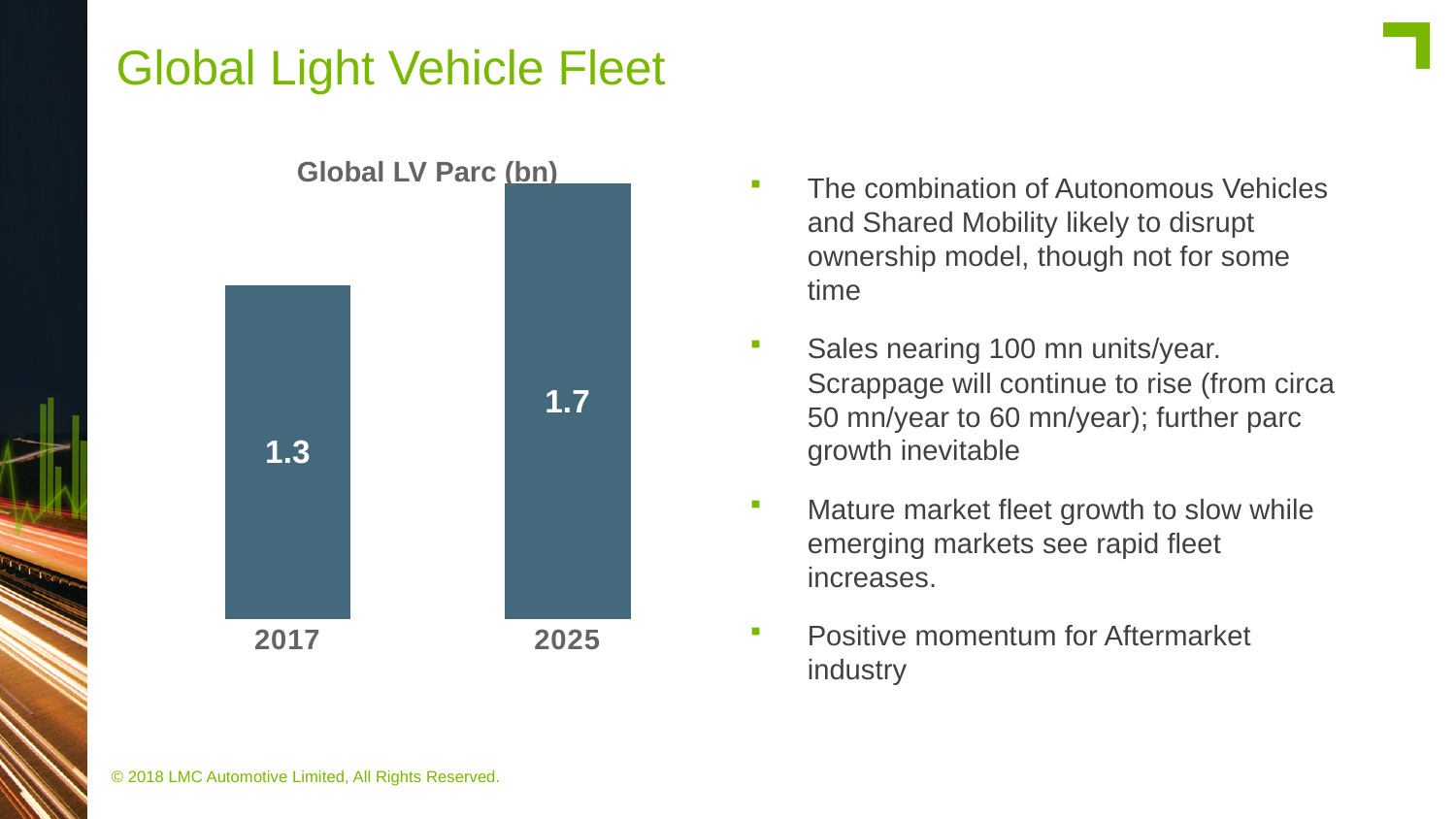
What kind of chart is used to show the Global LV Parc (bn) data? bar chart What unit is indicated in the chart title? bn How many bars are shown in the Global LV Parc (bn) chart? 2 Which year has the lower value in the Global LV Parc (bn) chart? 2017 Is the value for 2025 larger or smaller than the value for 2017 in the Global LV Parc (bn) chart? larger What is the value for 2017 in the Global LV Parc (bn) chart? 1.3 What is the value for 2025 in the Global LV Parc (bn) chart? 1.7 What is the difference between the 2025 and 2017 values in the Global LV Parc (bn) chart? 0.4 What is the title of the chart on the slide? Global LV Parc (bn) Do the values in the Global LV Parc (bn) chart rise or fall from 2017 to 2025? rise Which year has the higher value in the Global LV Parc (bn) chart? 2025